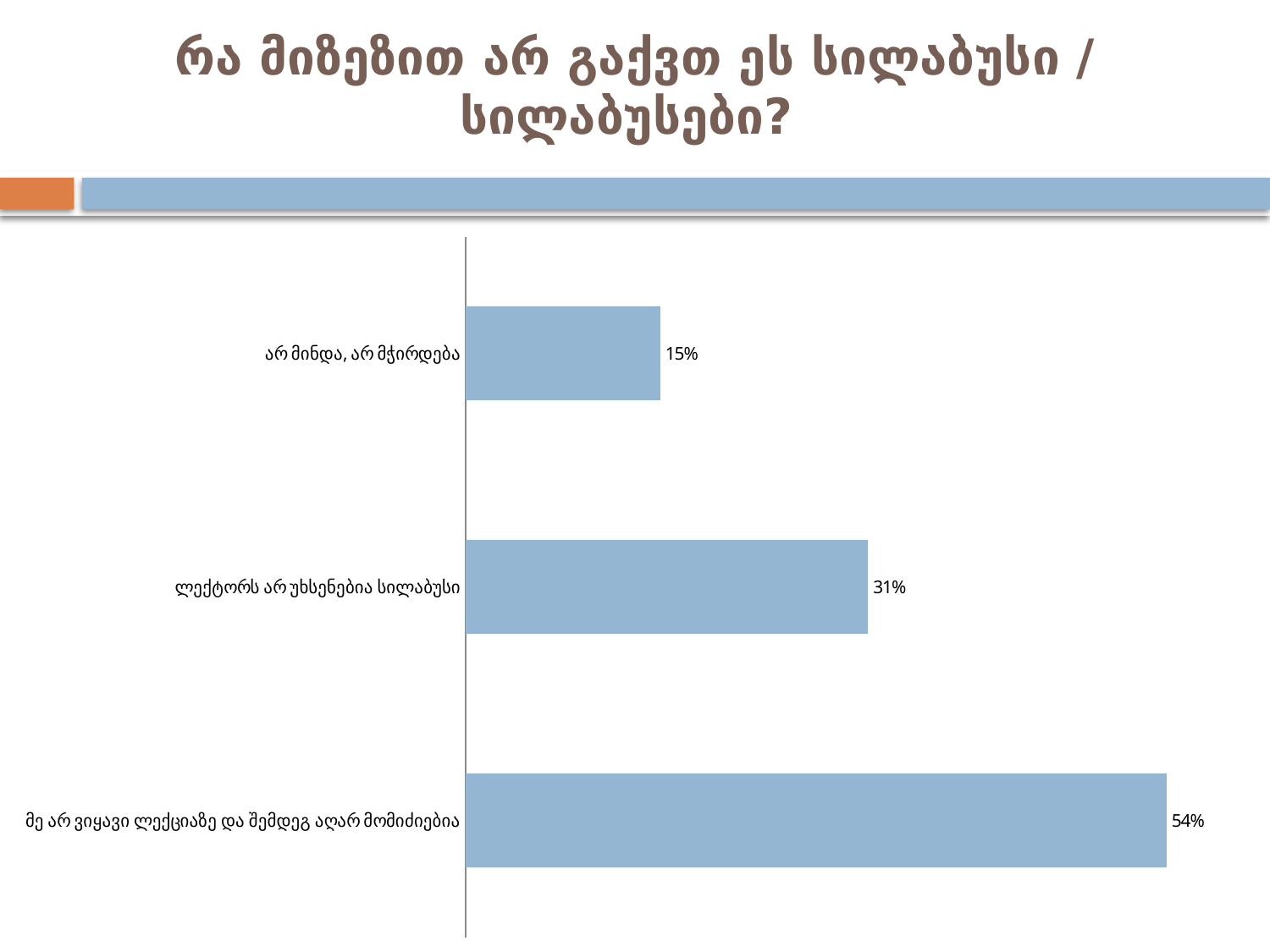
What is the value for "ლექტორს არ უხსენებია სილაბუსი"? 31% What is the difference between the values for "მე არ ვიყავი ლექციაზე და შემდეგ აღარ მომიძიებია" and "ლექტორს არ უხსენებია სილაბუსი"? 23% Which category has the highest value? მე არ ვიყავი ლექციაზე და შემდეგ აღარ მომიძიებია What is the title of the slide? რა მიზეზით არ გაქვთ ეს სილაბუსი / სილაბუსები? What is the value for "არ მინდა, არ მჭირდება"? 15% Which category has the lowest value? არ მინდა, არ მჭირდება What is the value for "მე არ ვიყავი ლექციაზე და შემდეგ აღარ მომიძიებია"? 54% How many categories are shown in the chart? 3 What kind of chart is shown on the slide? Bar chart What is the difference between the values for "ლექტორს არ უხსენებია სილაბუსი" and "არ მინდა, არ მჭირდება"? 16% Which is larger: the value for "ლექტორს არ უხსენებია სილაბუსი" or the value for "არ მინდა, არ მჭირდება"? ლექტორს არ უხსენებია სილაბუსი What colour are the bars in the chart? Light blue